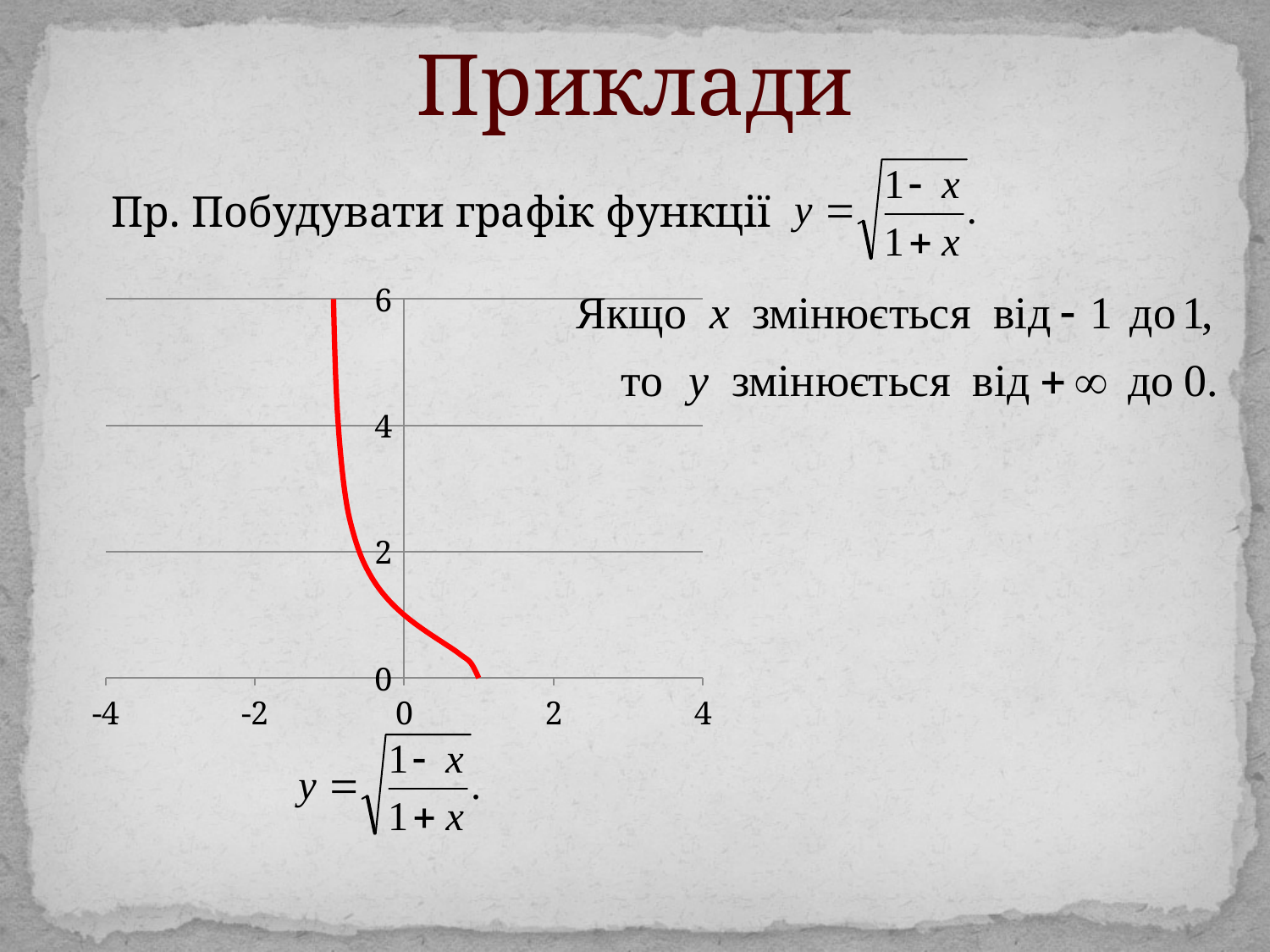
Is the value of the curve at x = 2 shown on the chart? no What is the y value at the right end of the curve, where it meets the x axis? 0 What is the lowest tick label on the x axis? -4 How many data series are plotted on the chart? 1 Is the value of the curve just to the right of x = -1 greater or less than 4? greater Is the value of the curve at x = 0 greater or less than 2? less How many tick labels are shown on the x axis? 5 What is the highest tick label on the y axis? 6 What kind of chart is shown on the slide? line chart Does the plotted curve rise or fall as x increases from left to right? fall